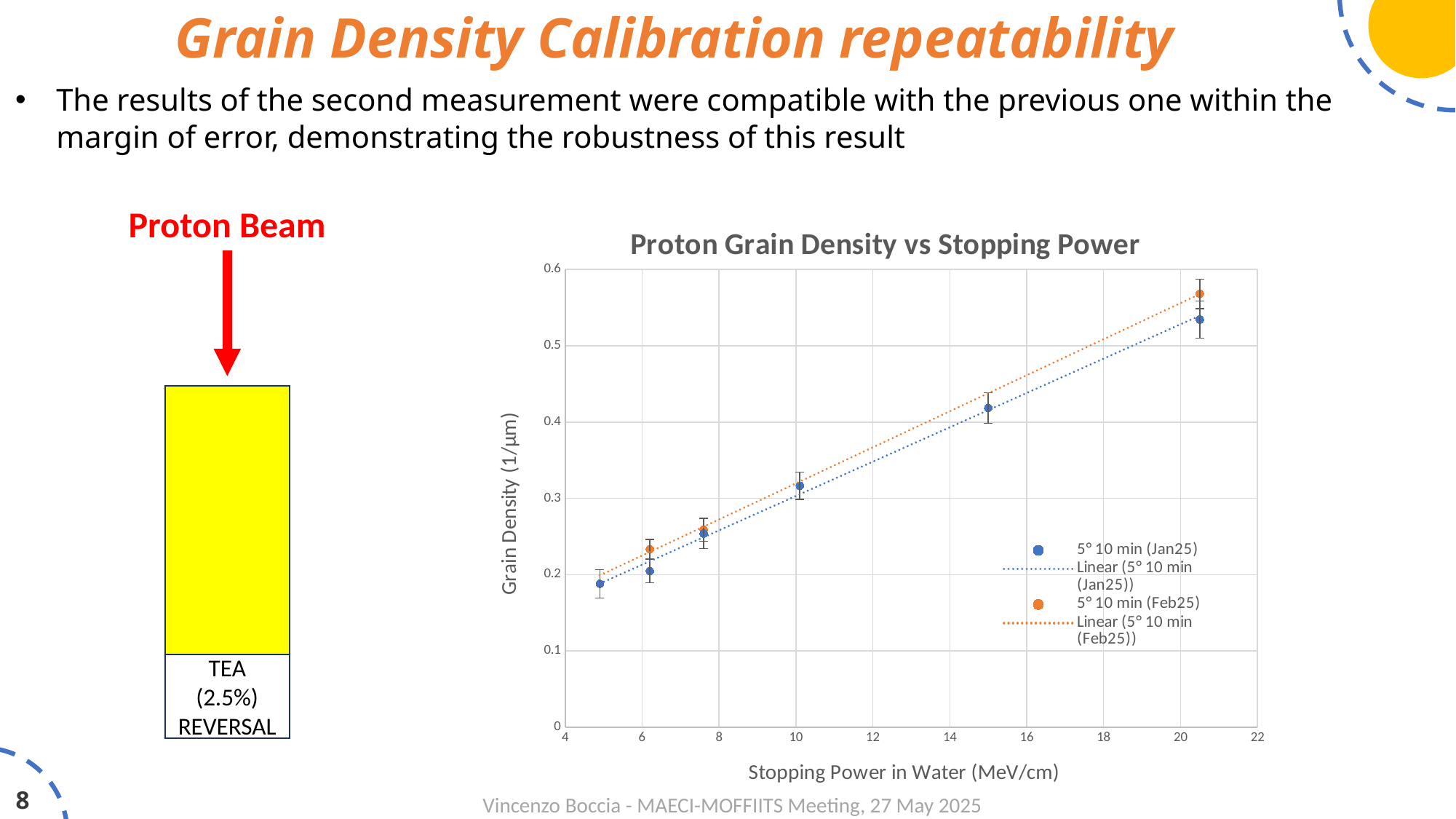
What is the label of the x axis of the chart? Stopping Power in Water (MeV/cm) What kind of chart is shown on the slide? Scatter chart Is the grain density of the points at a stopping power of about 10 MeV/cm greater or less than 0.3? greater Do the grain density values rise or fall as stopping power increases along the x axis? Rise At the highest stopping power (around 20.5 MeV/cm), which series has the larger grain density, 5° 10 min (Jan25) or 5° 10 min (Feb25)? 5° 10 min (Feb25) What is the title of the chart? Proton Grain Density vs Stopping Power How many entries does the chart legend list? 4 Is the grain density of the 5° 10 min (Jan25) point at a stopping power of about 15 MeV/cm greater or less than 0.4? greater Is the grain density of the 5° 10 min (Feb25) point at the highest stopping power (around 20.5 MeV/cm) greater or less than 0.5? greater